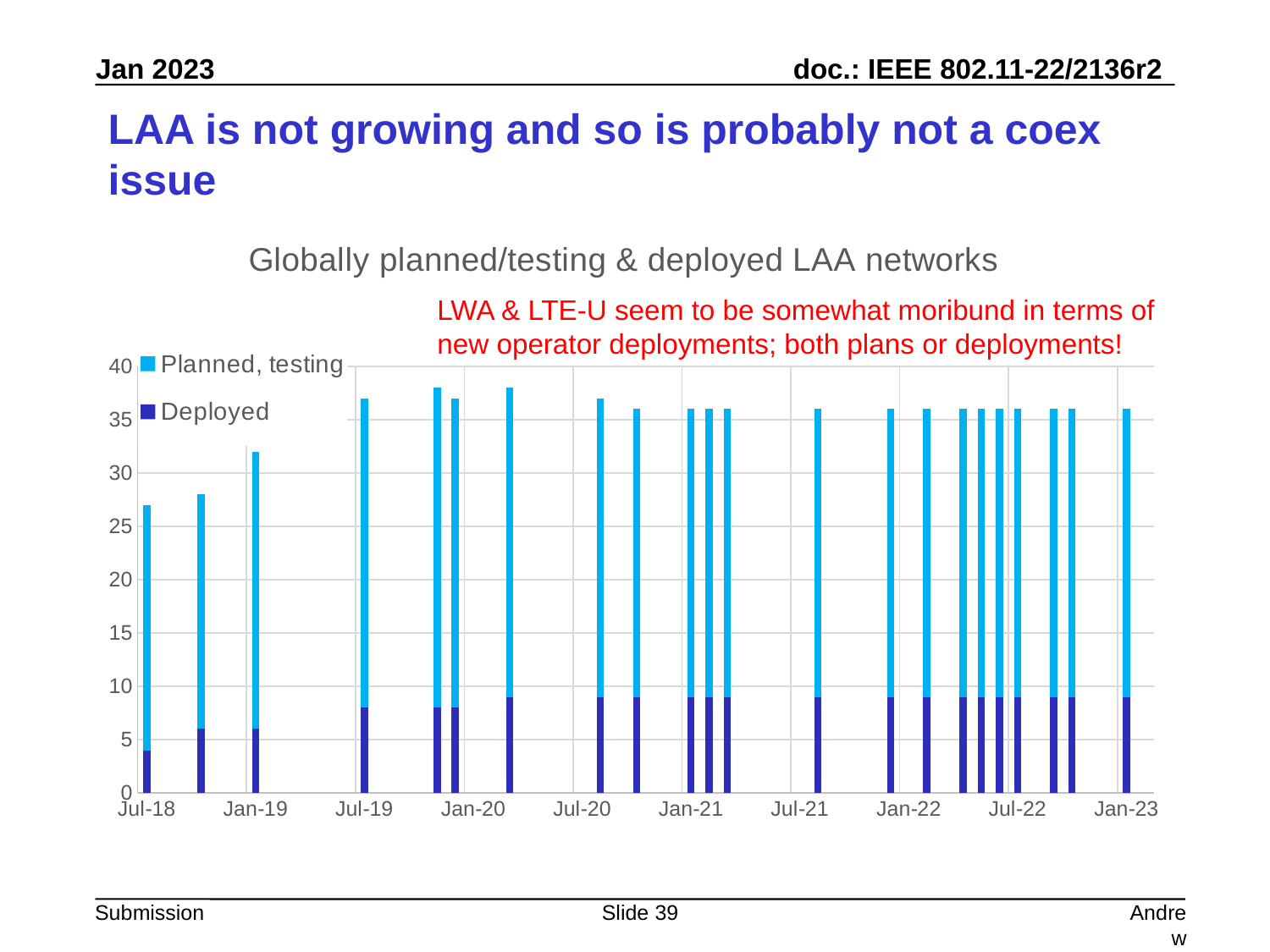
Which series is drawn in dark blue at the bottom of each bar? Deployed Is the Deployed value at Jan-23 greater or less than 5? greater Which date has the lowest total bar in the chart? Jul-18 Which bar has the lowest total height, Jul-18 or Jan-23? Jul-18 Is the Deployed value larger at Jul-18 or at Jan-23? Jan-23 What kind of chart is shown on the slide? Stacked bar chart Is the total height of the bar at Jul-18 greater or less than 30? less What is the title of the chart? Globally planned/testing & deployed LAA networks Is the total height of the bar at Jan-23 greater or less than 30? greater How many series does the chart legend list? 2 Does the Deployed series rise or fall from Jul-18 to Jan-23? rise